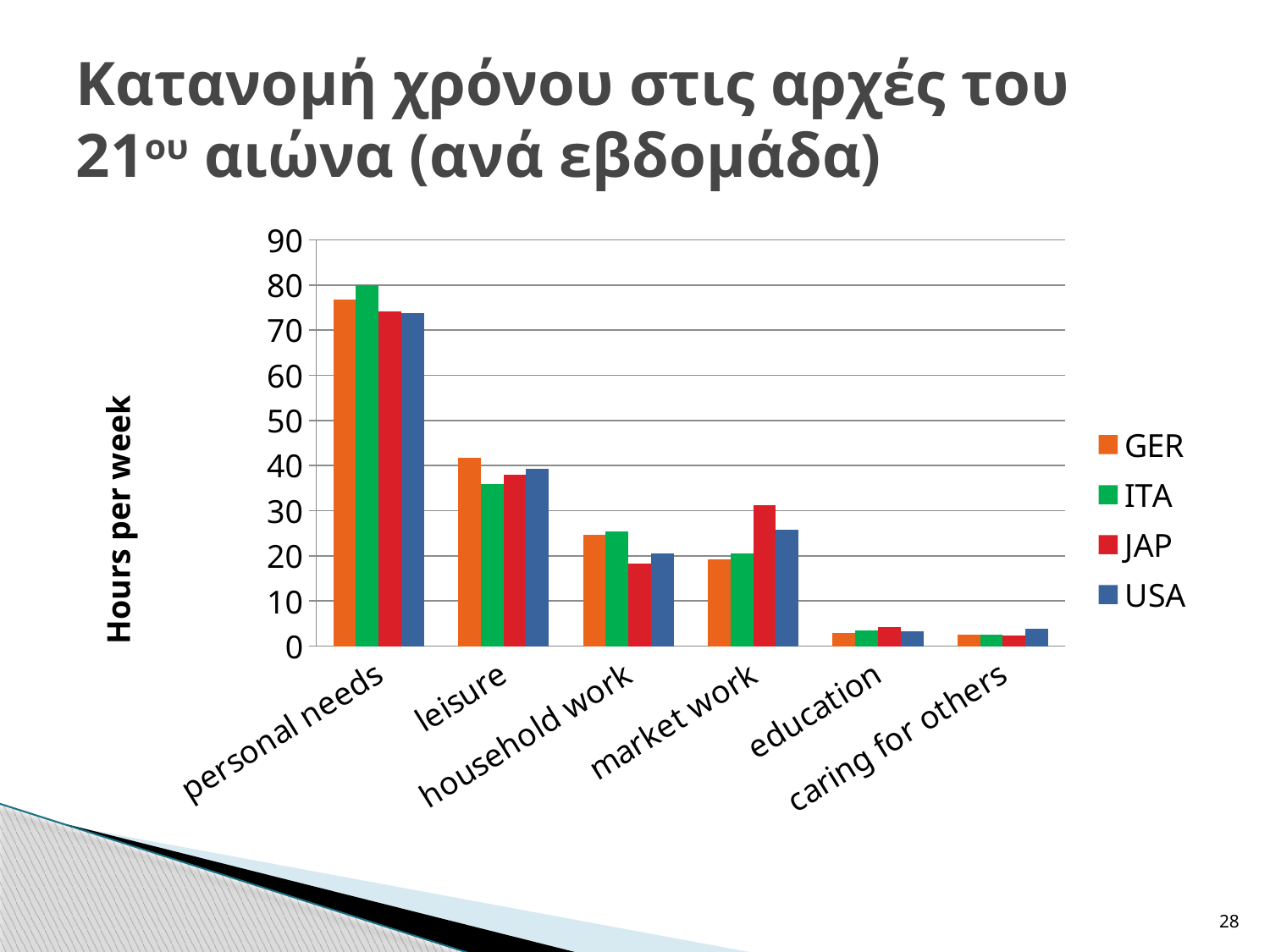
Which country has the highest value for leisure? GER How many series does the legend list? 4 How many categories are shown on the x axis? 6 Is the value for ITA in personal needs greater or less than 70? greater Which is larger for market work, the value for JAP or the value for GER? JAP Which country has the highest value for market work? JAP What kind of chart is shown on the slide? bar chart Which country has the highest value for personal needs? ITA Which country has the lowest value for household work? JAP Is the value for USA in leisure greater or less than 30? greater What is the label on the vertical axis? Hours per week